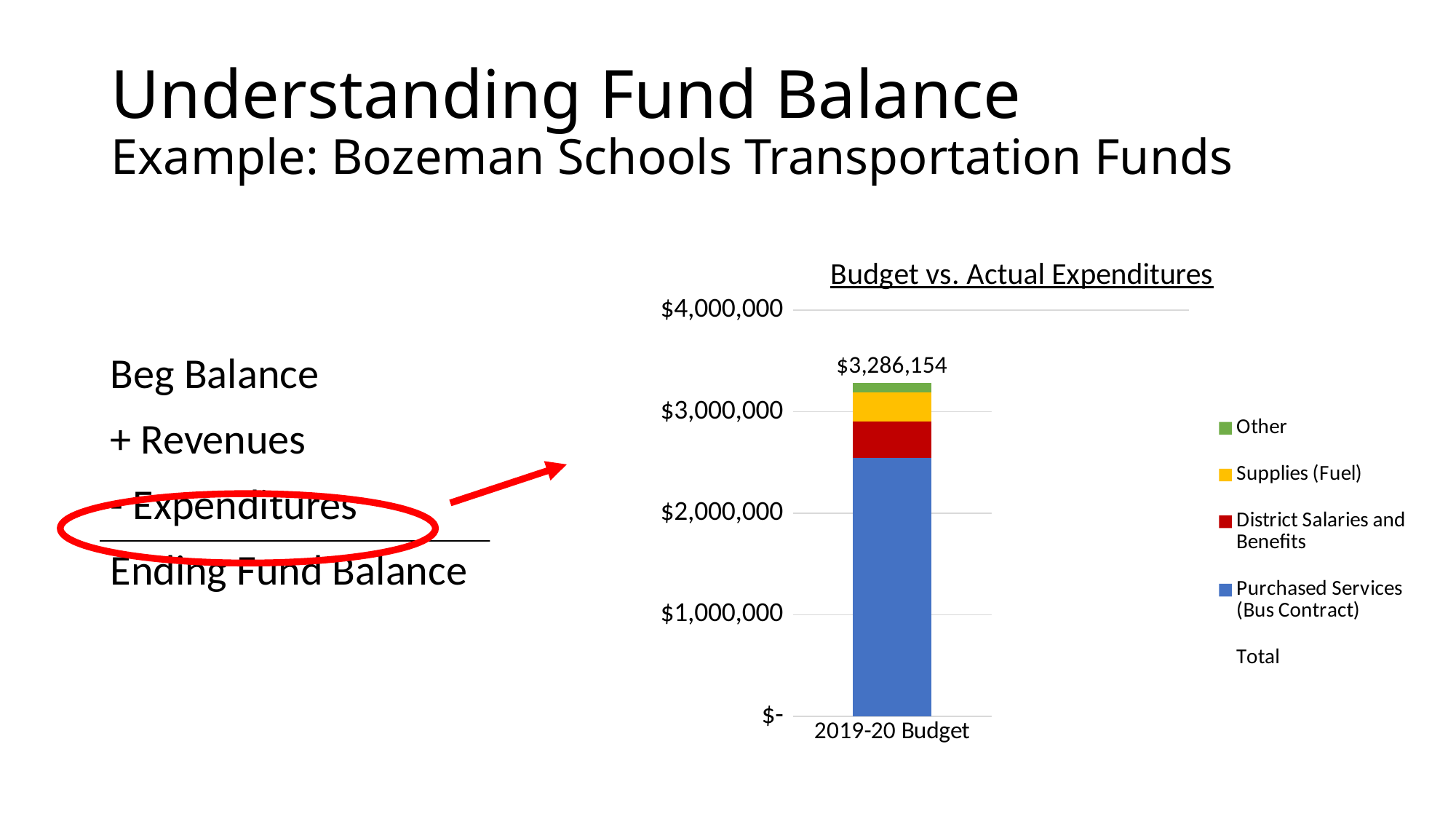
Is the value for Purchased Services (Bus Contract) in the 2019-20 Budget bar greater or less than $2,000,000? greater Is the value for Purchased Services (Bus Contract) in the 2019-20 Budget bar greater or less than $3,000,000? less What kind of chart is shown on the slide? Stacked bar chart How many entries does the chart's legend list? 5 How many bars (categories) are plotted on the x axis of the chart? 1 Is the total of the 2019-20 Budget bar greater or less than $3,000,000? greater Which is larger in the 2019-20 Budget bar: Purchased Services (Bus Contract) or District Salaries and Benefits? Purchased Services (Bus Contract) What is the title of the chart? Budget vs. Actual Expenditures What is the total value labelled on the 2019-20 Budget bar? $3,286,154 Which expenditure category makes up the largest segment of the 2019-20 Budget bar? Purchased Services (Bus Contract) Which expenditure category makes up the smallest segment of the 2019-20 Budget bar? Other What is the category label shown on the x axis of the chart? 2019-20 Budget